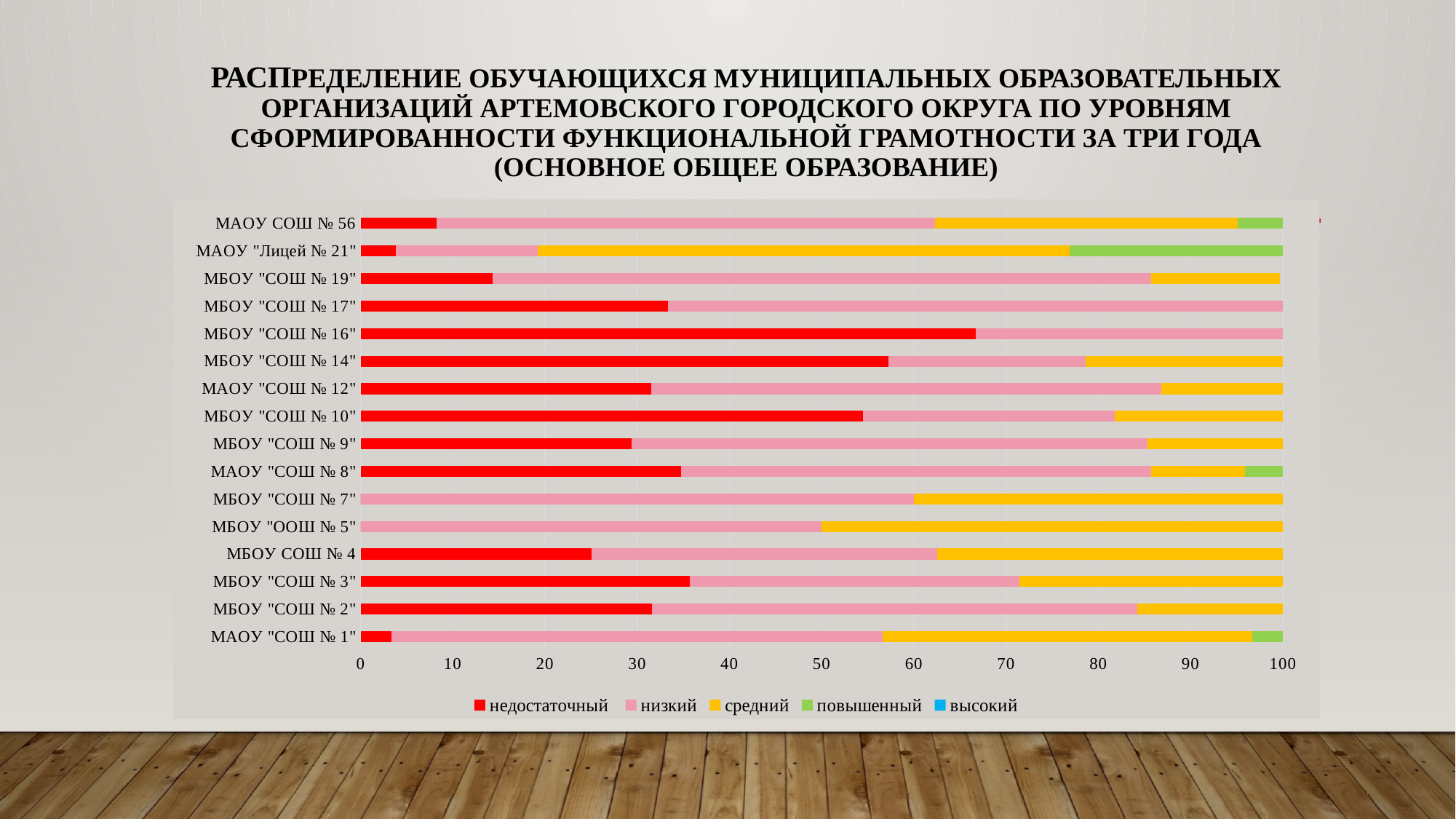
What kind of chart is shown on the slide? Stacked bar chart Which school has the largest повышенный (green) segment? МАОУ "Лицей № 21" How many series does the chart legend list? 5 How many schools (categories) are listed on the vertical axis of the chart? 16 How many schools show no недостаточный (red) segment at all? 2 Which has the larger недостаточный segment: МБОУ "СОШ № 10" or МБОУ "СОШ № 9"? МБОУ "СОШ № 10" Which series are listed in the chart legend? недостаточный, низкий, средний, повышенный, высокий Which school has the largest недостаточный (red) segment? МБОУ "СОШ № 16" Which two schools have bars made up only of недостаточный and низкий segments, with no средний segment? МБОУ "СОШ № 17" and МБОУ "СОШ № 16" Is the недостаточный value for МБОУ "СОШ № 16" greater or less than 60? greater Is the недостаточный value for МАОУ "Лицей № 21" greater or less than 10? less Is the недостаточный value for МБОУ "СОШ № 14" greater or less than 50? greater